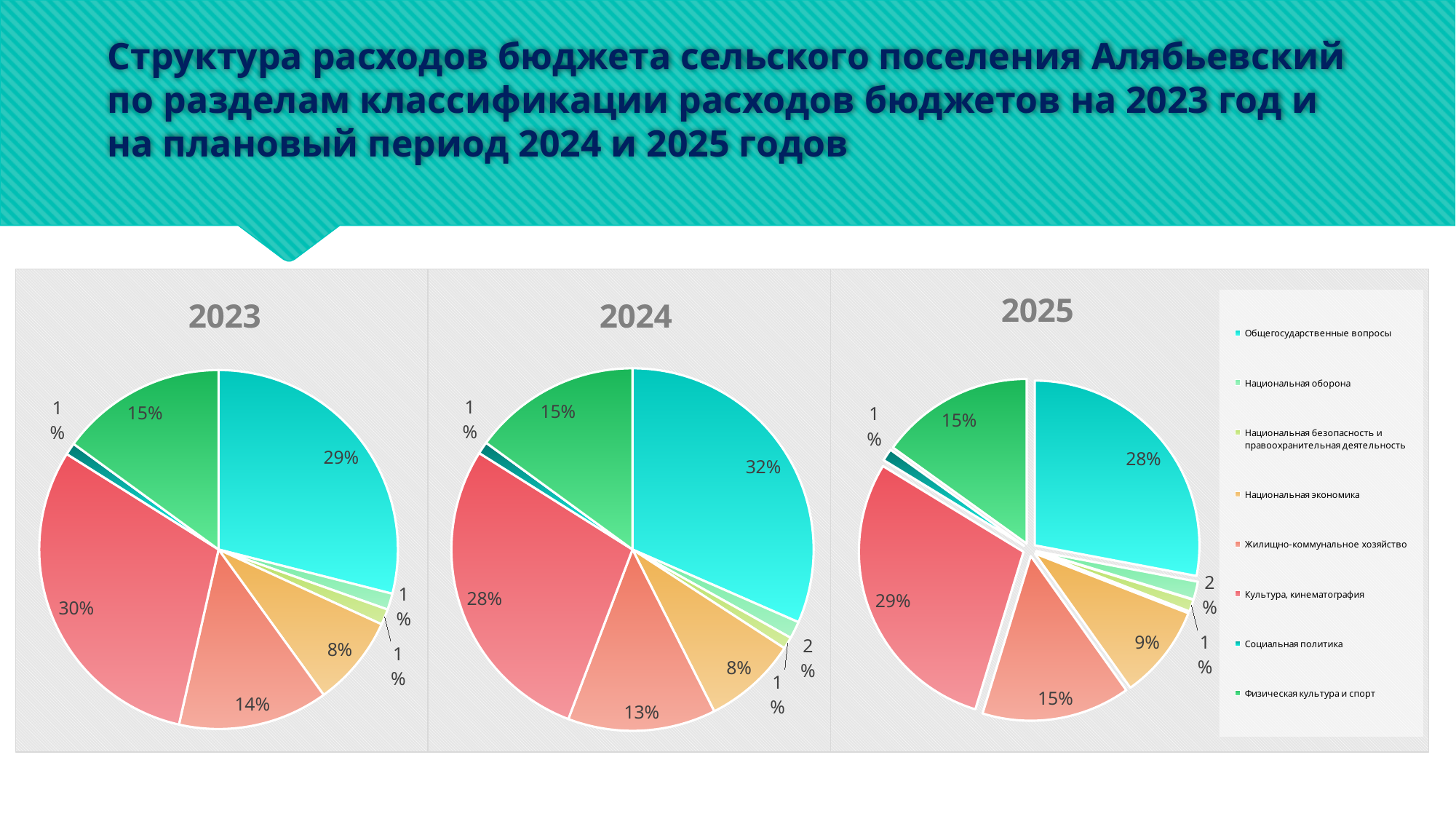
In the 2025 pie chart, what share is shown for Жилищно-коммунальное хозяйство? 15% In the 2024 pie chart, what is the difference between the shares of Общегосударственные вопросы and Культура, кинематография? 4% In the 2024 pie chart, what share is shown for Культура, кинематография? 28% What is the title of the leftmost chart? 2023 How many pie charts are shown on the slide? 3 In the 2024 pie chart, which category has the largest share? Общегосударственные вопросы What type of chart is used for the 2025 data? Pie chart How many categories does the legend list? 8 In the 2023 pie chart, what share is shown for Общегосударственные вопросы? 29% In the 2023 pie chart, which is larger: the share of Жилищно-коммунальное хозяйство or the share of Физическая культура и спорт? Физическая культура и спорт In the 2023 pie chart, which category has the largest share? Культура, кинематография In the 2025 pie chart, what share is shown for Национальная экономика? 9%